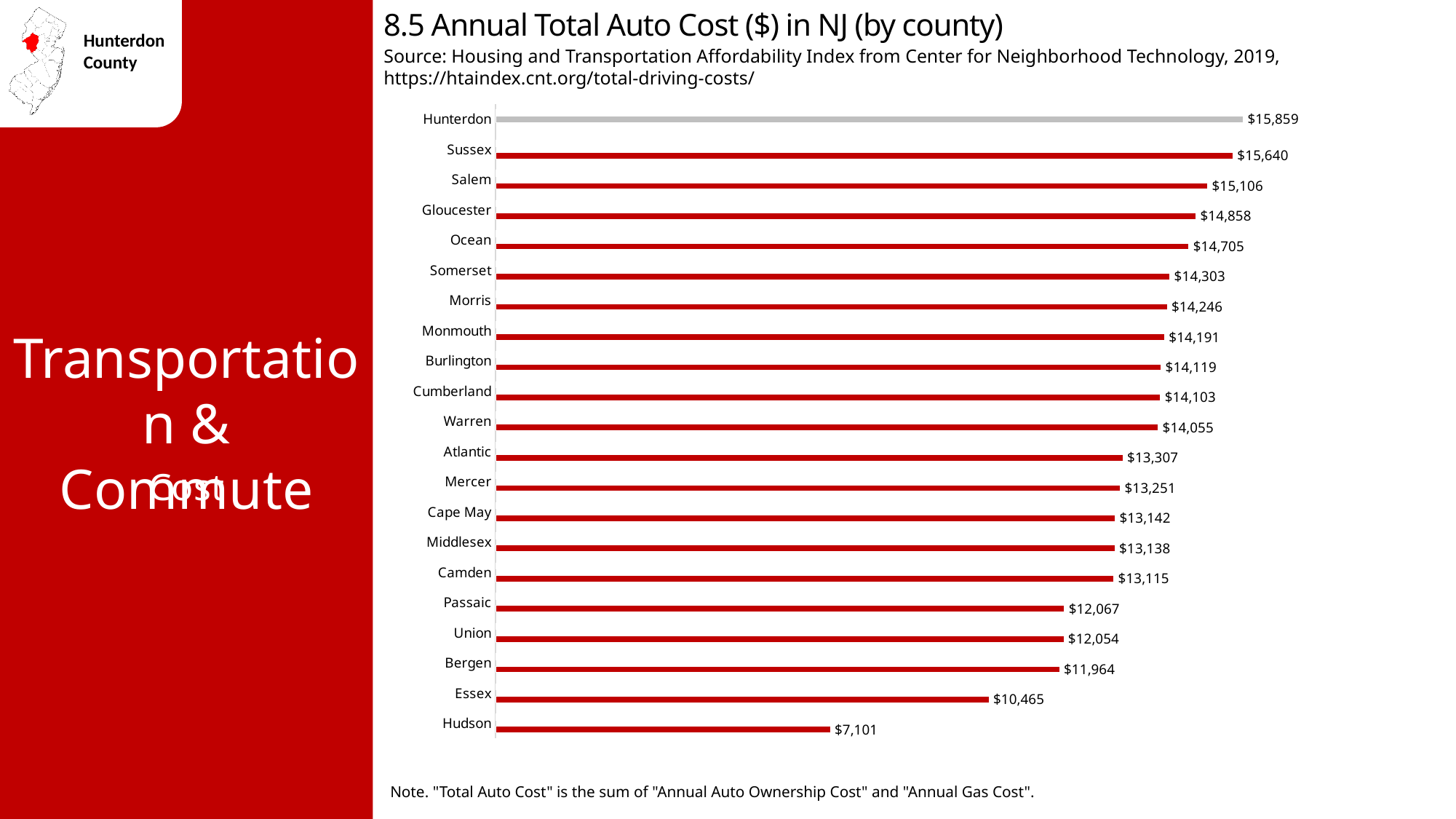
What is the annual total auto cost for Morris County? $14,246 What is the annual total auto cost for Hudson County? $7,101 Which county has the lowest annual total auto cost? Hudson What type of chart is used on this slide? Bar chart Which has a higher annual total auto cost, Essex or Bergen? Bergen Which has a higher annual total auto cost, Ocean or Somerset? Ocean What is the difference in annual total auto cost between Sussex and Salem? $534 What is the annual total auto cost for Hunterdon County? $15,859 What is the difference in annual total auto cost between Hunterdon and Hudson? $8,758 Which county has the highest annual total auto cost? Hunterdon How many counties are shown in the chart? 21 Which county's bar is shown in a different colour (grey) from the others? Hunterdon